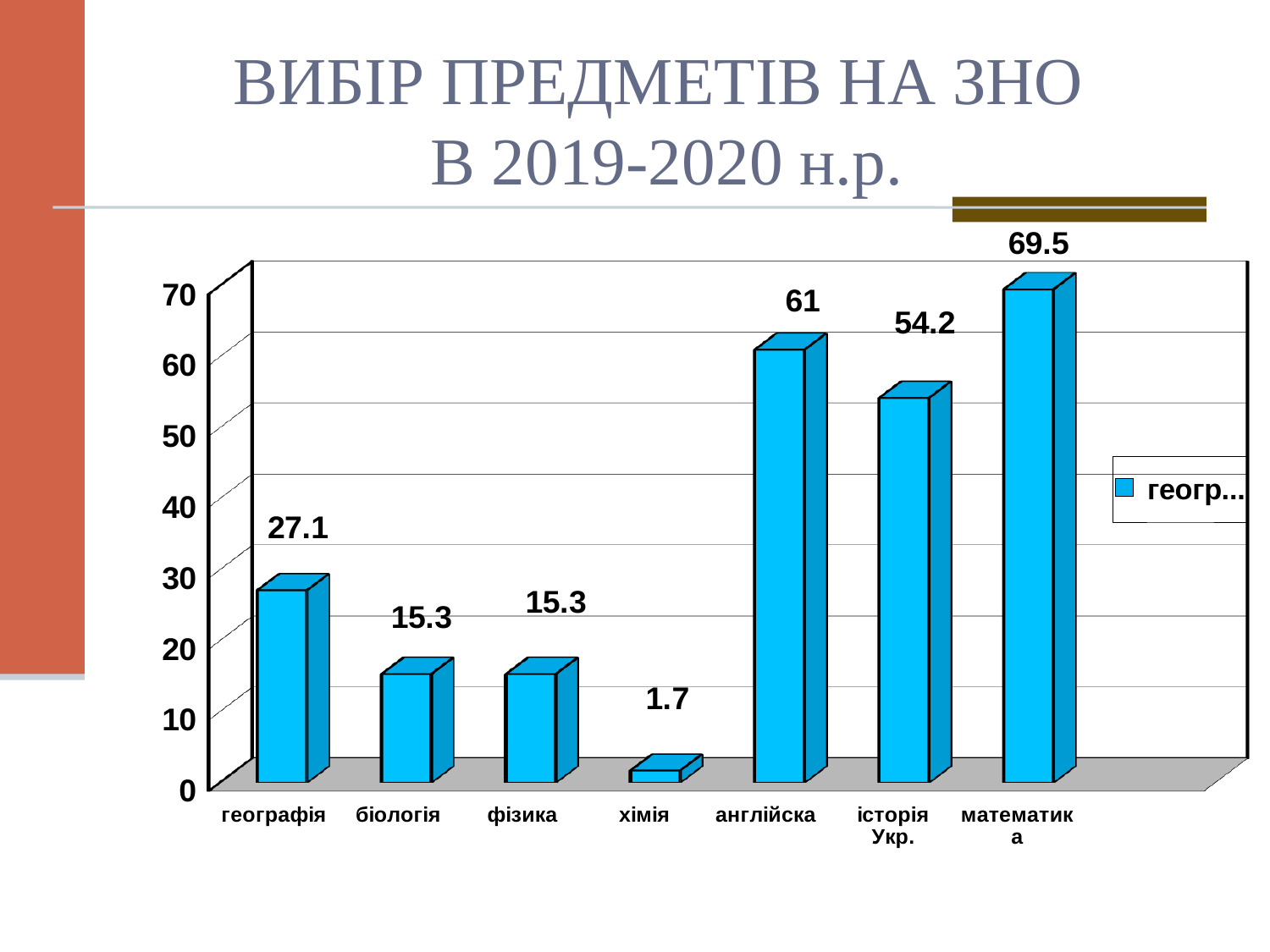
What is the value for англійска? 61 How many categories are shown on the x axis? 7 What is the value for географія? 27.1 Is the value for історія Укр. greater or less than 50? greater What kind of chart is shown on the slide? bar chart Which category has the lowest value? хімія Which is larger, the value for географія or the value for біологія? географія What is the value for історія Укр.? 54.2 Which category has the highest value? математика What is the difference between the values for математика and англійска? 8.5 What is the title of the slide? ВИБІР ПРЕДМЕТІВ НА ЗНО В 2019-2020 н.р. What is the value for хімія? 1.7